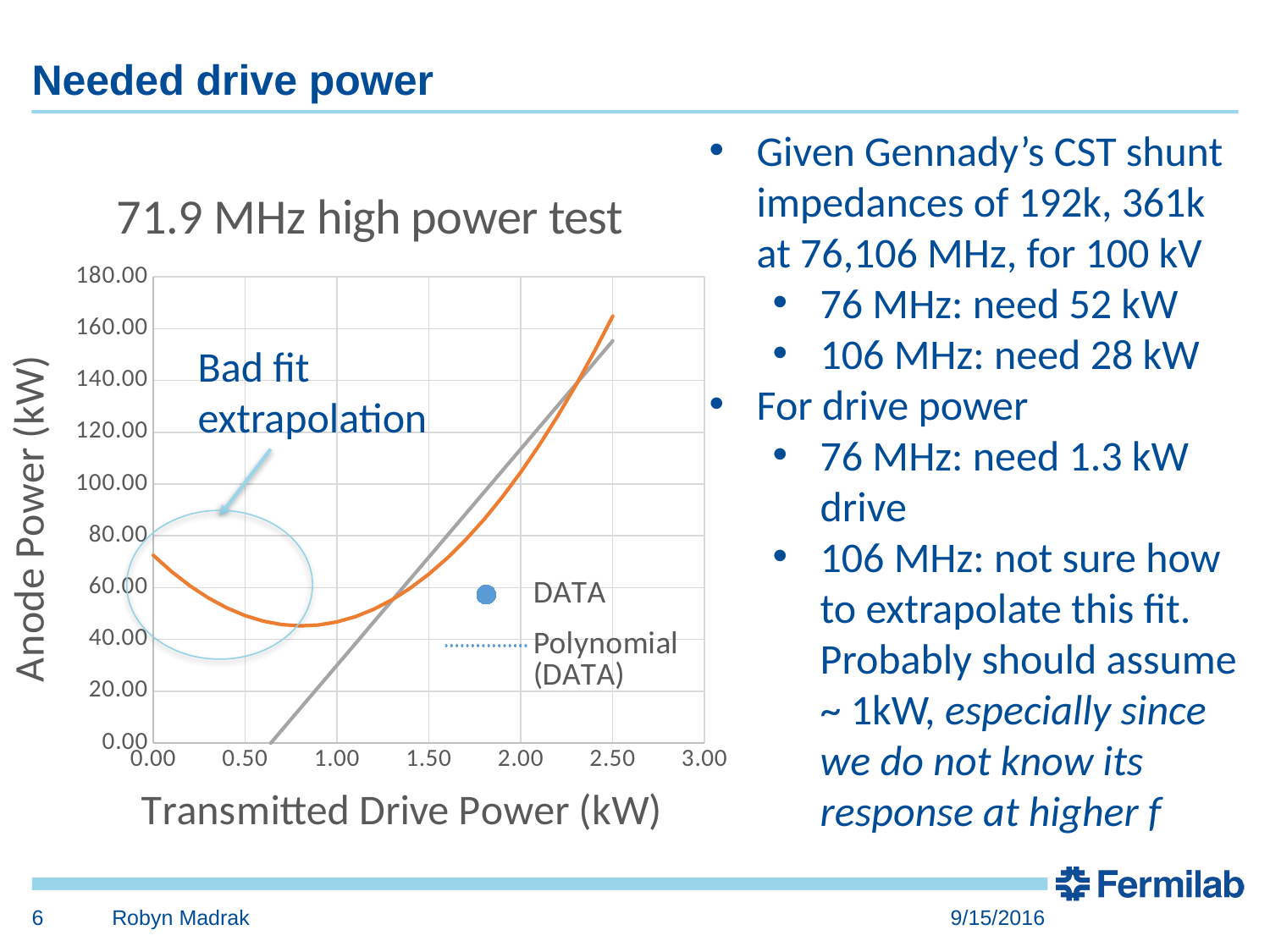
What kind of chart is shown on the slide? Scatter chart with a polynomial trendline Is the lowest point of the polynomial fit curve greater or less than 60 kW anode power? less Does the polynomial fit curve rise or fall between transmitted drive powers of 0.00 kW and 0.50 kW? fall What is the label of the x axis? Transmitted Drive Power (kW) How many entries does the chart legend list? 2 What is the maximum value shown on the y axis? 180.00 Is the value of the polynomial fit curve at a transmitted drive power of 2.50 kW greater or less than 140? greater Is the value of the polynomial fit curve at a transmitted drive power of 0.00 kW greater or less than 60? greater What is the title of the chart? 71.9 MHz high power test Does the polynomial fit curve rise or fall between transmitted drive powers of 1.50 kW and 2.50 kW? rise What is the maximum value shown on the x axis? 3.00